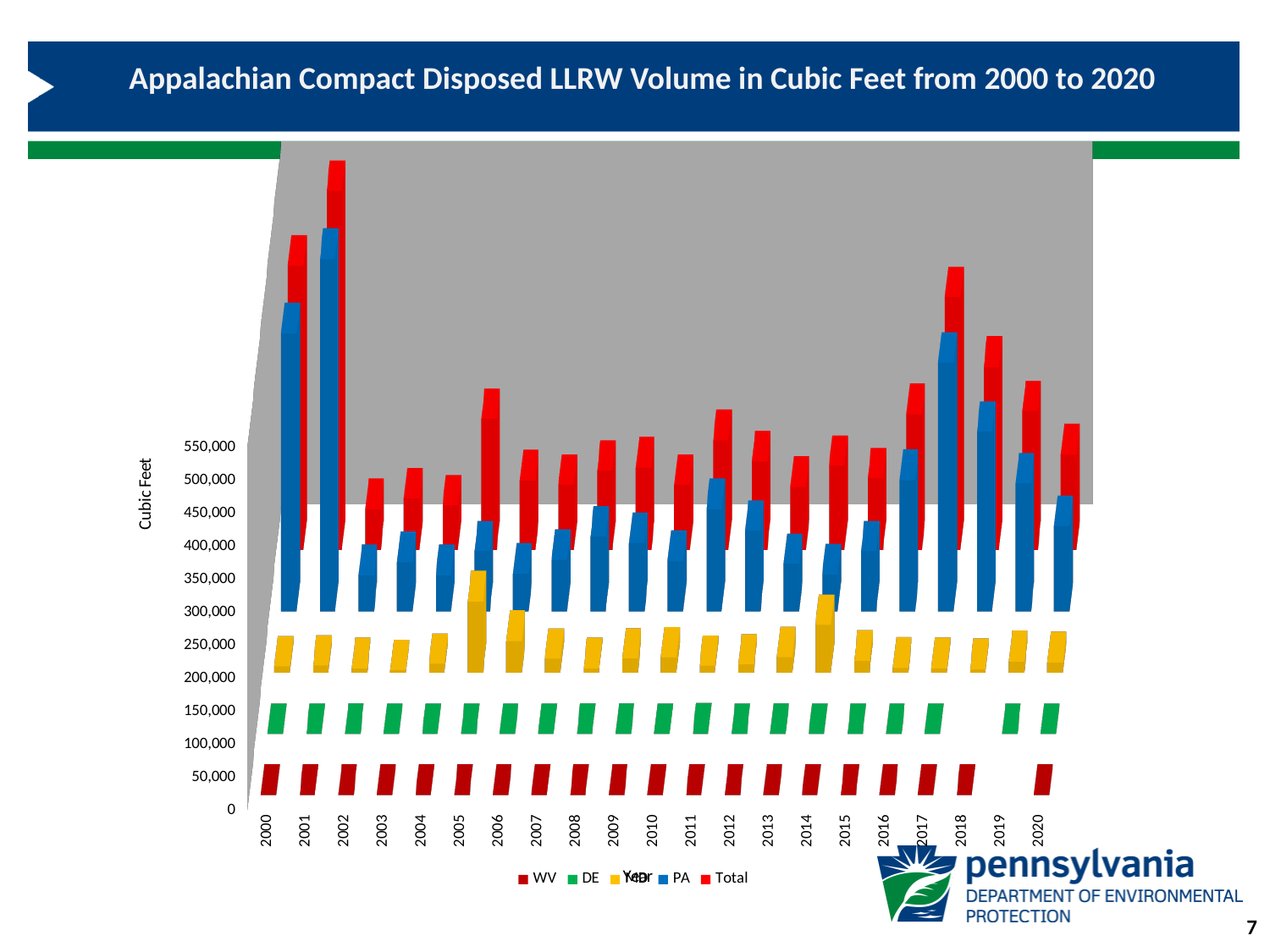
Is the Total value larger in 2018 or in 2019? 2018 What kind of chart is shown on the slide? Bar chart Is the PA value larger in 2001 or in 2002? 2001 What colour represents the PA series in the legend? Blue How many years are shown along the x axis? 21 Is the Total value larger in 2006 or in 2007? 2006 Which year has the highest Total disposed volume? 2001 Which year has the highest PA disposed volume? 2001 How many series does the legend list? 5 What is the title of the chart? Appalachian Compact Disposed LLRW Volume in Cubic Feet from 2000 to 2020